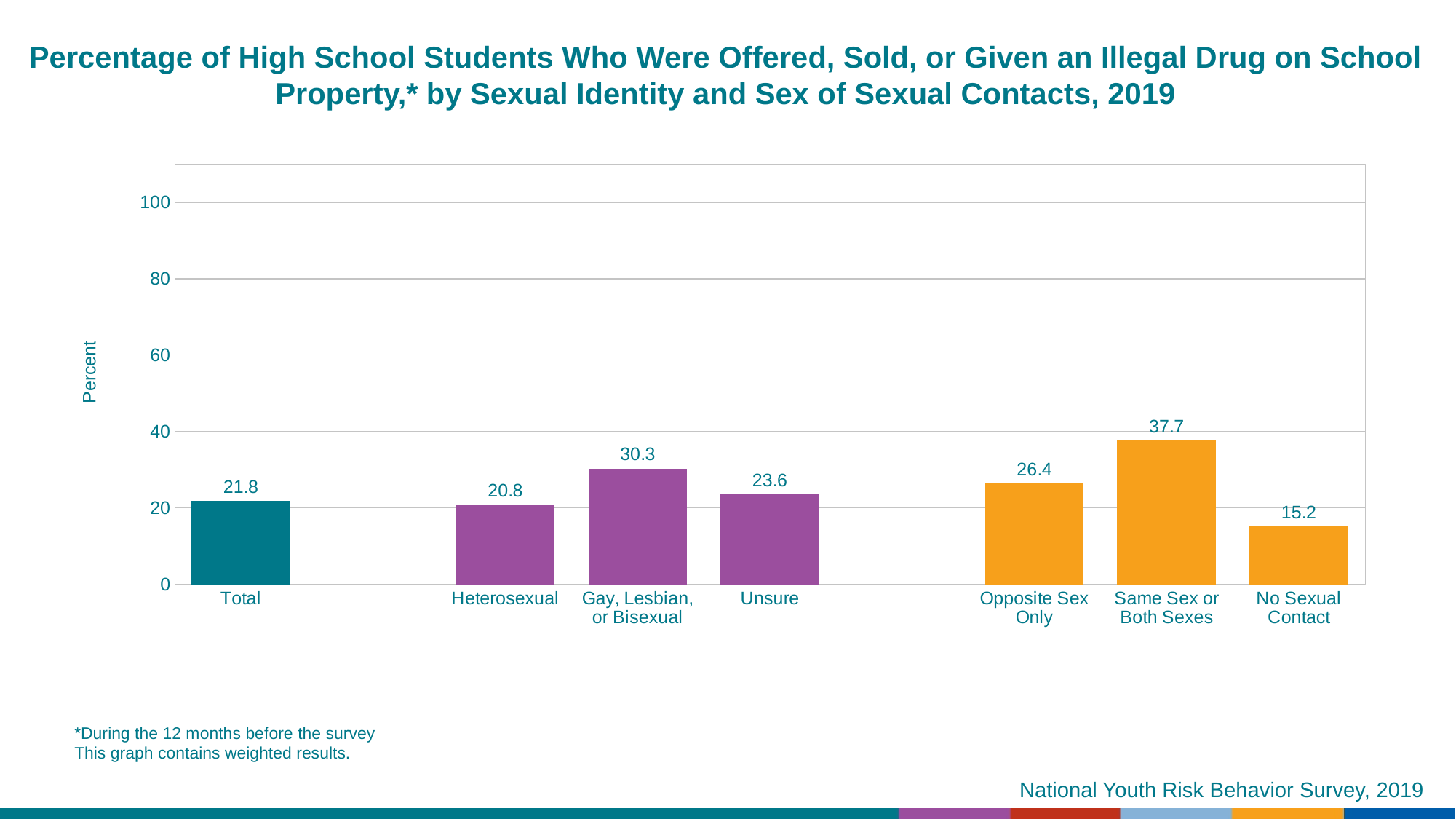
How many categories are shown on the chart? 7 What is the value for Gay, Lesbian, or Bisexual students? 30.3 What is the difference between the values for Same Sex or Both Sexes and Opposite Sex Only? 11.3 What is the value for Unsure students? 23.6 Which is larger, the value for Unsure or the value for Heterosexual? Unsure Is the value for Same Sex or Both Sexes greater or less than 40? less What is the difference between the values for Gay, Lesbian, or Bisexual and Heterosexual? 9.5 What kind of chart is this? bar chart Which category has the lowest value? No Sexual Contact Which category has the highest value? Same Sex or Both Sexes What is the value for Total? 21.8 What is the value for students with No Sexual Contact? 15.2